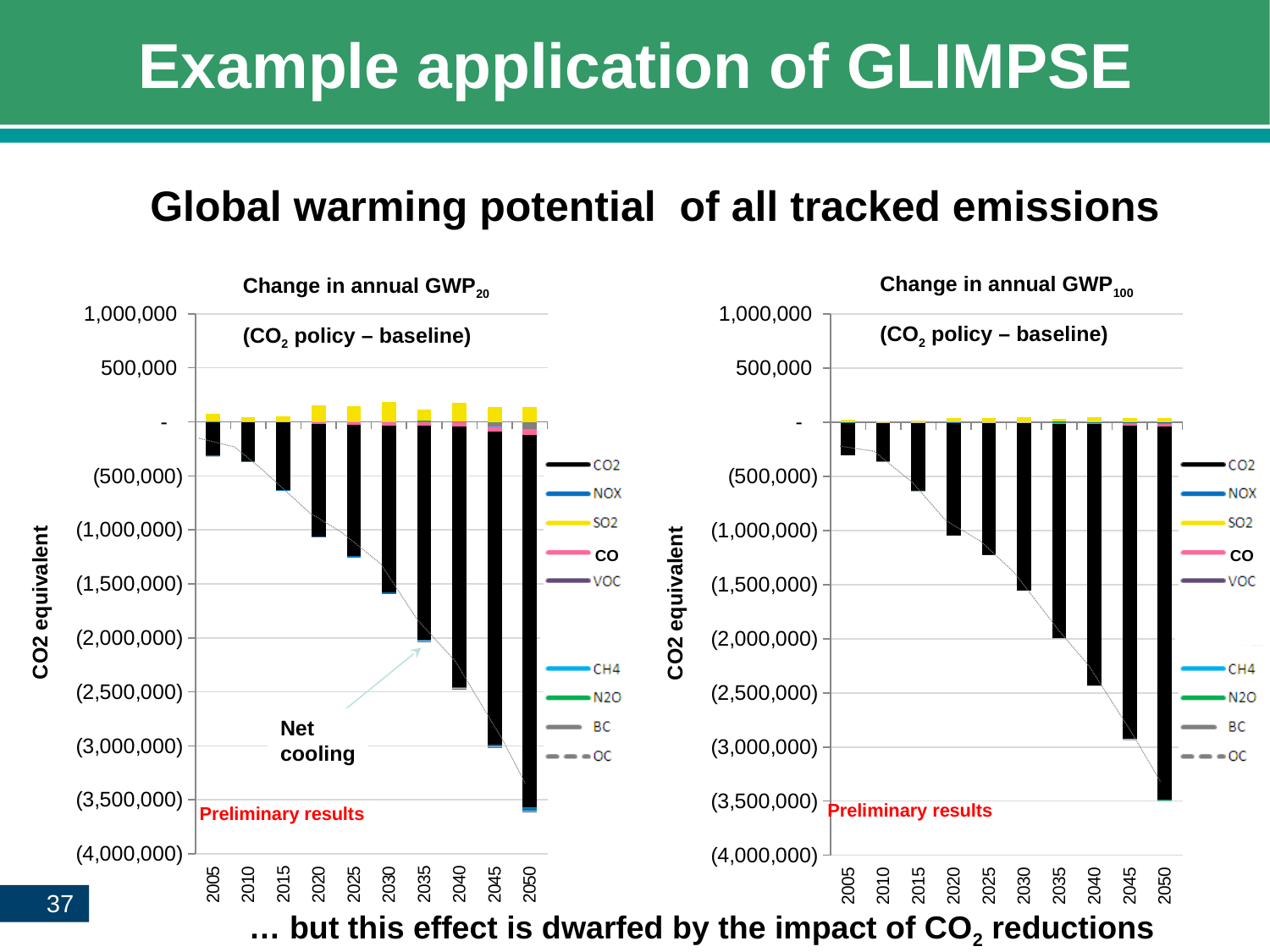
In the 'Change in annual GWP20' chart, which year has the most negative CO2 bar? 2050 How many series does the legend of the 'Change in annual GWP20' chart list? 9 What kind of chart is the 'Change in annual GWP20' chart? bar chart In the 'Change in annual GWP20' chart, does the CO2 bar for 2040 extend below (2,000,000)? yes What is the y-axis label of the 'Change in annual GWP20' chart? CO2 equivalent In the 'Change in annual GWP100' chart, does the CO2 bar for 2040 extend below (2,500,000)? no In the 'Change in annual GWP20' chart, do the CO2 bars become more negative or less negative from 2005 to 2050? more negative How many years are shown on the x axis of the 'Change in annual GWP100' chart? 10 In the 'Change in annual GWP100' chart, which year shows a larger CO2 reduction, 2005 or 2050? 2050 In the 'Change in annual GWP100' chart, which year has the smallest (least negative) CO2 bar? 2005 In the 'Change in annual GWP100' chart, does the CO2 bar for 2010 extend below (500,000)? no Which legend entry in the 'Change in annual GWP20' chart is shown in yellow? SO2